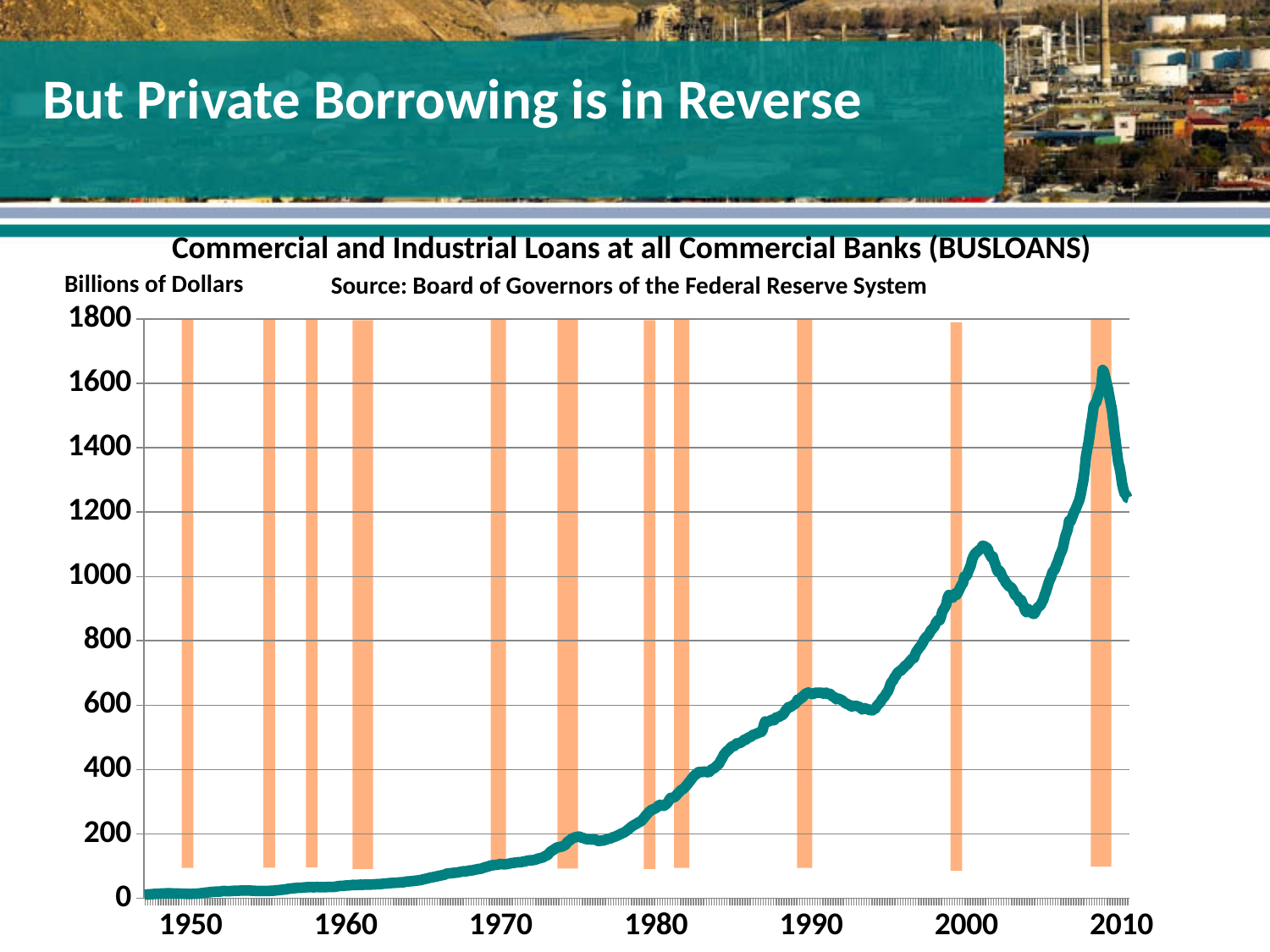
Is the highest point of the line greater or less than 1400? greater Which year has the larger value on the line, 1970 or 1990? 1990 What unit is the vertical axis of the chart measured in? Billions of Dollars Is the value of the line in 2000 greater or less than 800? greater What kind of chart is shown on the slide? line chart Is the value of the line in 1950 greater or less than 200? less Does the line rise or fall between its peak around 2008 and the end of the series in 2010? fall What is the title of the chart? Commercial and Industrial Loans at all Commercial Banks (BUSLOANS) Does the line generally rise or fall from 1950 to 2008? rise What is the highest value shown on the vertical axis? 1800